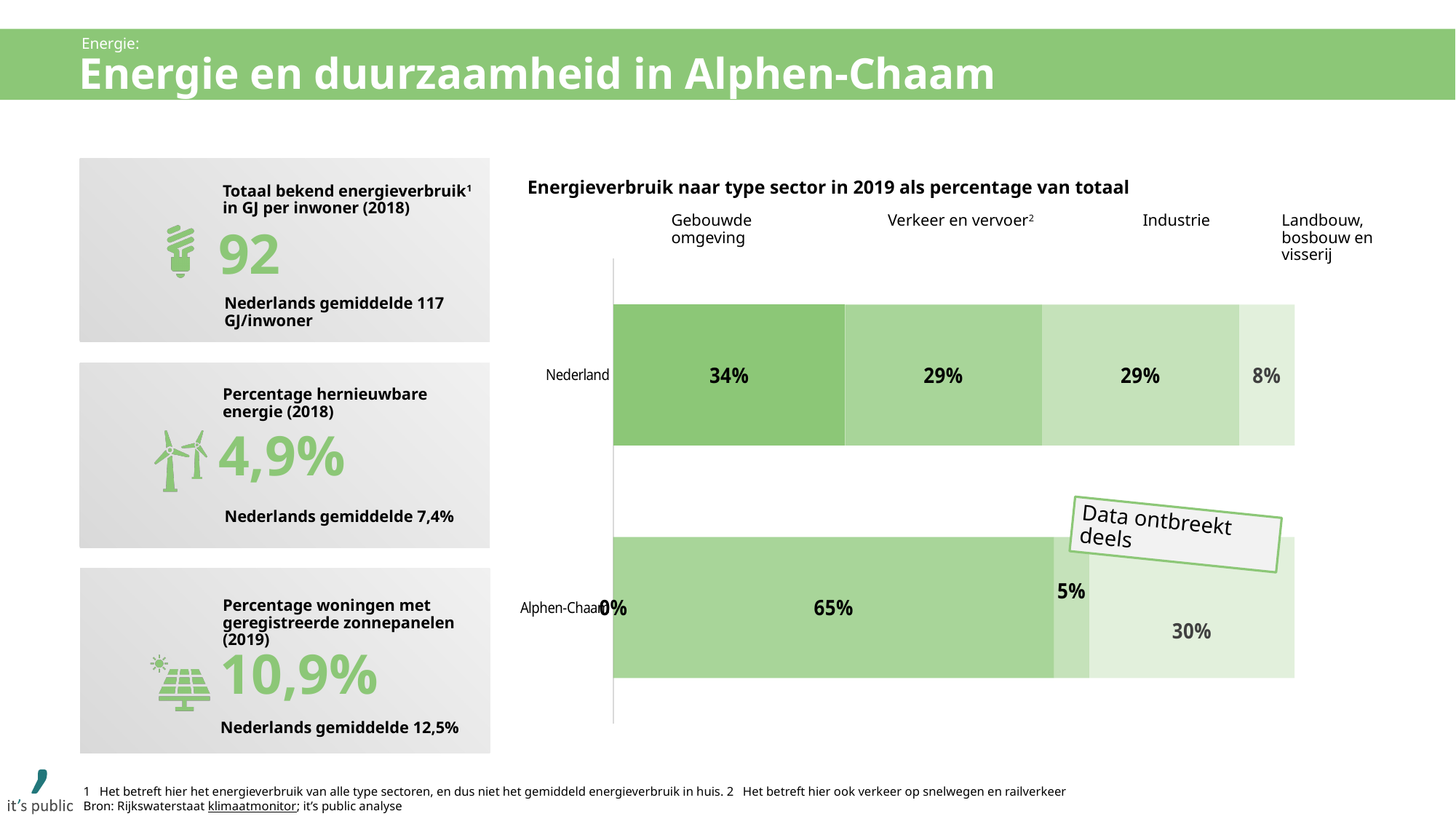
In the chart 'Energieverbruik naar type sector in 2019', what is the value for Landbouw, bosbouw en visserij for Nederland? 8% In the chart 'Energieverbruik naar type sector in 2019', which sector has the lowest share for Nederland? Landbouw, bosbouw en visserij In the chart 'Energieverbruik naar type sector in 2019', what is the value for Landbouw, bosbouw en visserij for Alphen-Chaam? 30% In the chart 'Energieverbruik naar type sector in 2019', what is the value for Gebouwde omgeving for Nederland? 34% How many regions (bars) are shown in the chart 'Energieverbruik naar type sector in 2019'? 2 In the chart 'Energieverbruik naar type sector in 2019', what is the value for Verkeer en vervoer for Alphen-Chaam? 65% What type of chart is shown under the title 'Energieverbruik naar type sector in 2019 als percentage van totaal'? Stacked bar chart In the chart 'Energieverbruik naar type sector in 2019', which sector has the highest share for Alphen-Chaam? Verkeer en vervoer How many sectors (series) are shown in the chart 'Energieverbruik naar type sector in 2019'? 4 In the chart 'Energieverbruik naar type sector in 2019', what is the value for Industrie for Alphen-Chaam? 5% In the chart 'Energieverbruik naar type sector in 2019', what is the difference between the Verkeer en vervoer share for Alphen-Chaam and for Nederland? 36 percentage points In the chart 'Energieverbruik naar type sector in 2019', which is larger: the Industrie share for Nederland or for Alphen-Chaam? Nederland